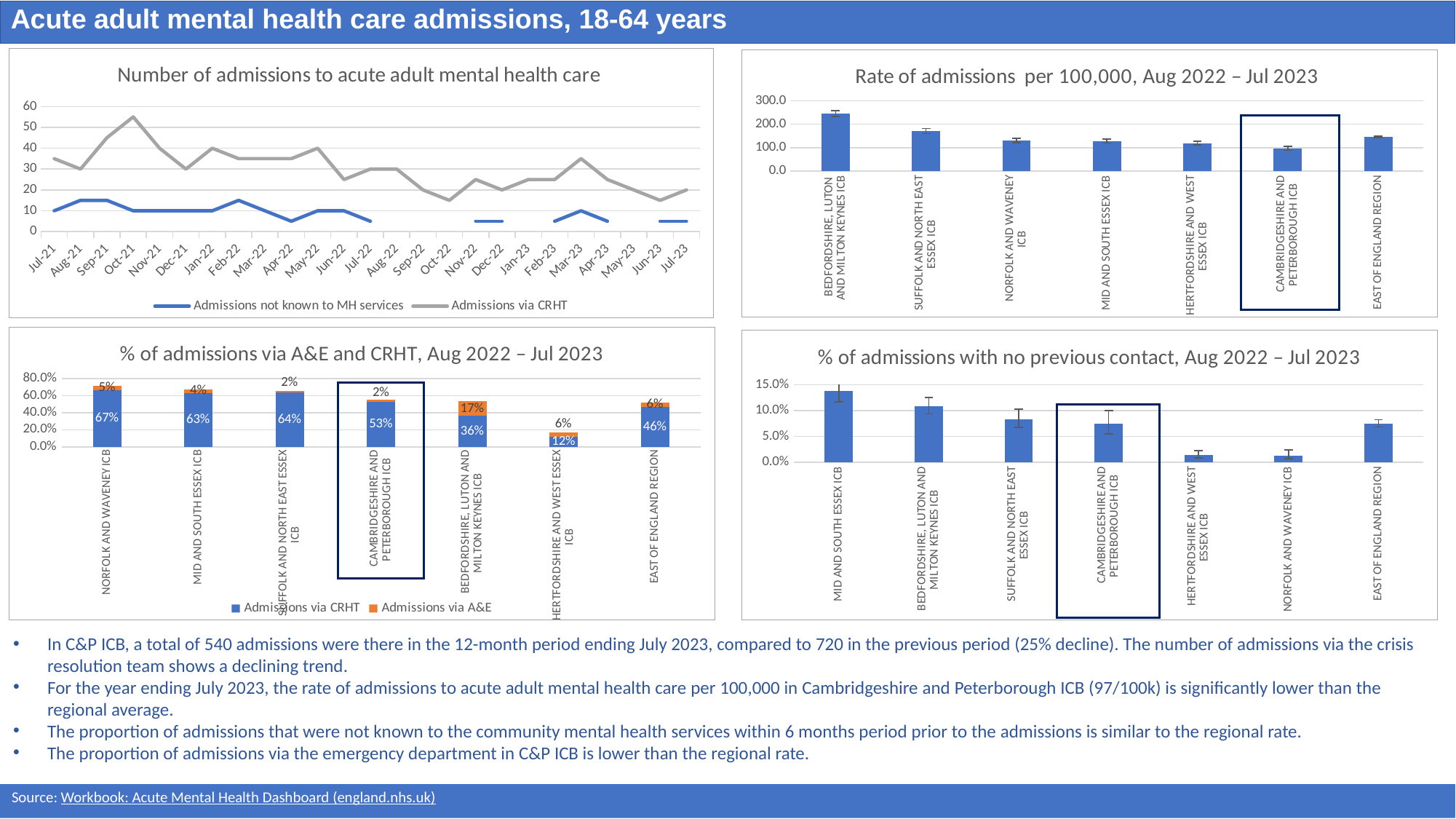
In the chart titled '% of admissions via A&E and CRHT, Aug 2022 – Jul 2023', what is the combined percentage of admissions via CRHT and A&E for Norfolk and Waveney ICB? 72% How many series does the legend list in the chart titled 'Number of admissions to acute adult mental health care'? 2 In the chart titled 'Rate of admissions per 100,000, Aug 2022 – Jul 2023', which ICB has the lowest rate? Cambridgeshire and Peterborough ICB In the chart titled '% of admissions via A&E and CRHT, Aug 2022 – Jul 2023', which ICB has the lowest percentage of admissions via CRHT? Hertfordshire and West Essex ICB In the chart titled 'Rate of admissions per 100,000, Aug 2022 – Jul 2023', which ICB has the highest rate? Bedfordshire, Luton and Milton Keynes ICB In the chart titled '% of admissions via A&E and CRHT, Aug 2022 – Jul 2023', how many percentage points higher is the CRHT share for Norfolk and Waveney ICB than for Cambridgeshire and Peterborough ICB? 14 percentage points In the chart titled '% of admissions with no previous contact, Aug 2022 – Jul 2023', which ICB has the highest value? Mid and South Essex ICB In the chart titled 'Rate of admissions per 100,000, Aug 2022 – Jul 2023', is the value for Bedfordshire, Luton and Milton Keynes ICB greater or less than 200.0? greater In the chart titled '% of admissions via A&E and CRHT, Aug 2022 – Jul 2023', what percentage of admissions in Cambridgeshire and Peterborough ICB were via CRHT? 53% What kind of chart is the chart titled 'Number of admissions to acute adult mental health care'? Line chart In the chart titled '% of admissions via A&E and CRHT, Aug 2022 – Jul 2023', which ICB has the highest percentage of admissions via A&E? Bedfordshire, Luton and Milton Keynes ICB In the chart titled '% of admissions via A&E and CRHT, Aug 2022 – Jul 2023', what percentage of admissions in Bedfordshire, Luton and Milton Keynes ICB were via A&E? 17%